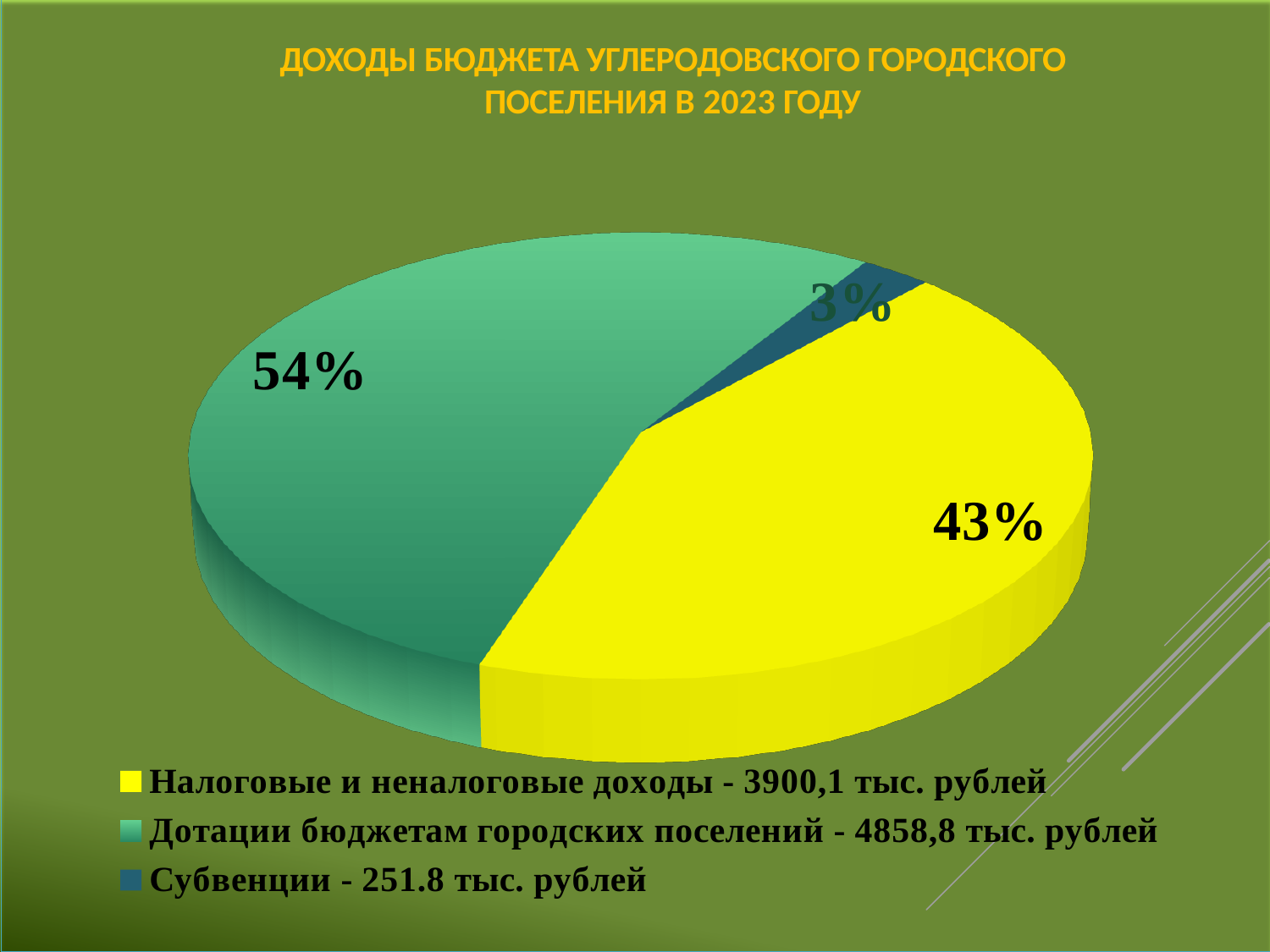
What share of the pie does the slice for 'Налоговые и неналоговые доходы' represent? 43% What kind of chart is shown on the slide? Pie chart Which category has the smallest slice of the pie? Субвенции What colour is the slice for 'Налоговые и неналоговые доходы'? Yellow According to the legend, what amount in thousand rubles corresponds to 'Налоговые и неналоговые доходы'? 3900,1 тыс. рублей What is the difference in percentage points between the 'Дотации бюджетам городских поселений' slice and the 'Налоговые и неналоговые доходы' slice? 11 Which is larger: the slice for 'Налоговые и неналоговые доходы' or the slice for 'Субвенции'? Налоговые и неналоговые доходы How many slices does the pie chart have? 3 According to the legend, what amount in thousand rubles corresponds to 'Субвенции'? 251.8 тыс. рублей What share of the pie does the slice for 'Дотации бюджетам городских поселений' represent? 54% What share of the pie does the slice for 'Субвенции' represent? 3% Which category has the largest slice of the pie? Дотации бюджетам городских поселений